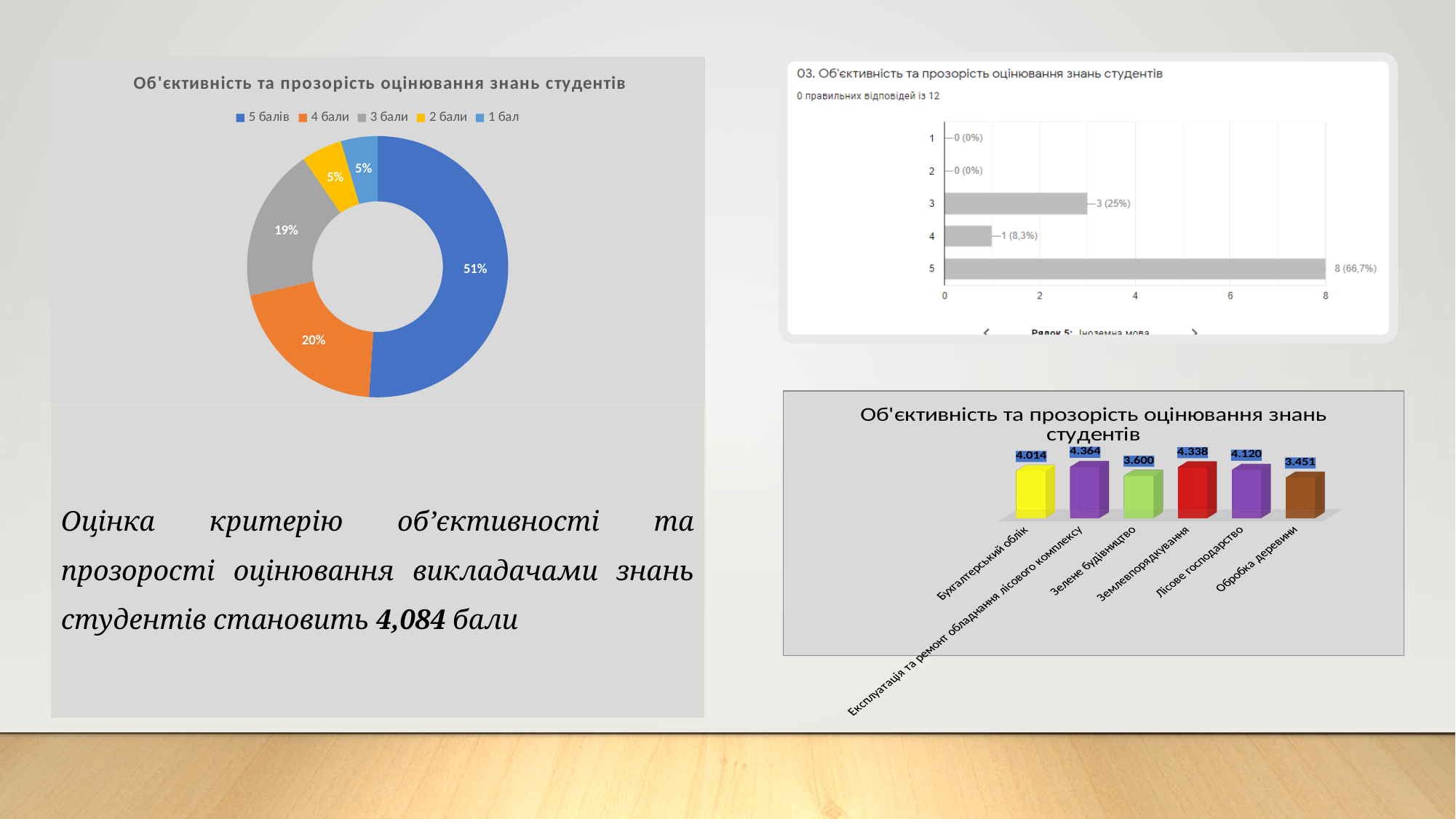
In the doughnut chart on the top left, which category has the largest share? 5 балів In the bar chart on the bottom right, what value is shown for "Зелене будівництво"? 3.600 In the bar chart on the bottom right, which category has the lowest value? Обробка деревини In the bar chart on the bottom right, how many categories are shown? 6 In the horizontal bar chart on the top right, what value is shown for category 3? 3 (25%) In the doughnut chart on the top left, what is the difference between the shares for "4 бали" and "3 бали"? 1% In the doughnut chart on the top left, what share is shown for "5 балів"? 51% What type of chart is shown on the top right of the slide? Bar chart In the horizontal bar chart on the top right, which category has the highest value? 5 How many entries does the legend of the doughnut chart on the top left list? 5 In the horizontal bar chart on the top right, what value is shown for category 5? 8 (66,7%) In the doughnut chart on the top left, what share is shown for "3 бали"? 19%